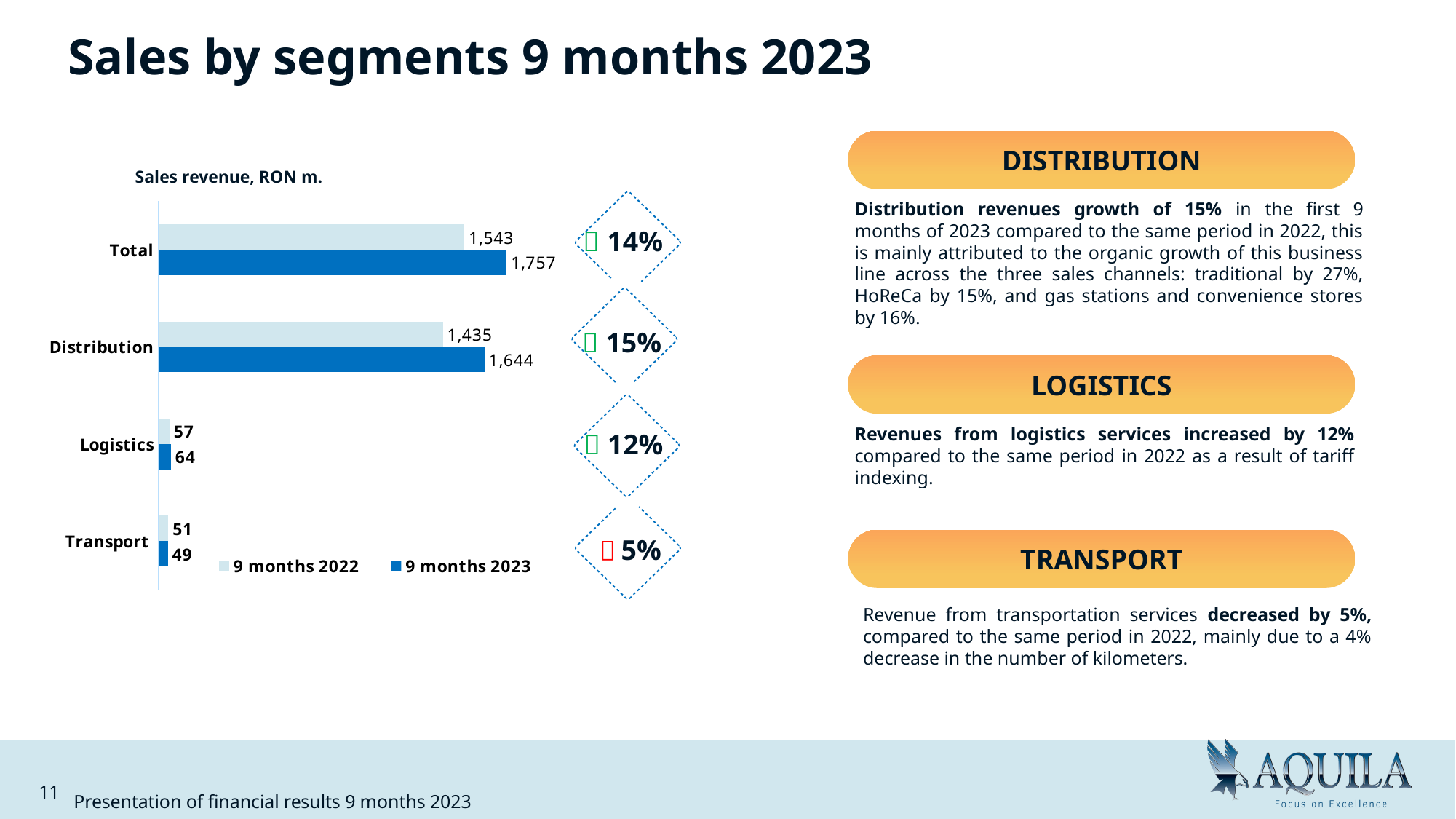
Which category has the lowest sales revenue in 9 months 2023? Transport How many series does the legend list? 2 How many categories are shown on the chart? 4 What is the Transport sales revenue for 9 months 2022? 51 What is the Distribution sales revenue for 9 months 2022? 1,435 Which is larger, the Transport revenue for 9 months 2022 or for 9 months 2023? 9 months 2022 What kind of chart is shown on the slide? Bar chart What is the title of the chart? Sales revenue, RON m. Which segment (excluding Total) has the highest sales revenue in 9 months 2023? Distribution What is the Logistics sales revenue for 9 months 2023? 64 What is the difference between the Total sales revenue for 9 months 2023 and 9 months 2022? 214 What is the Total sales revenue for 9 months 2023? 1,757